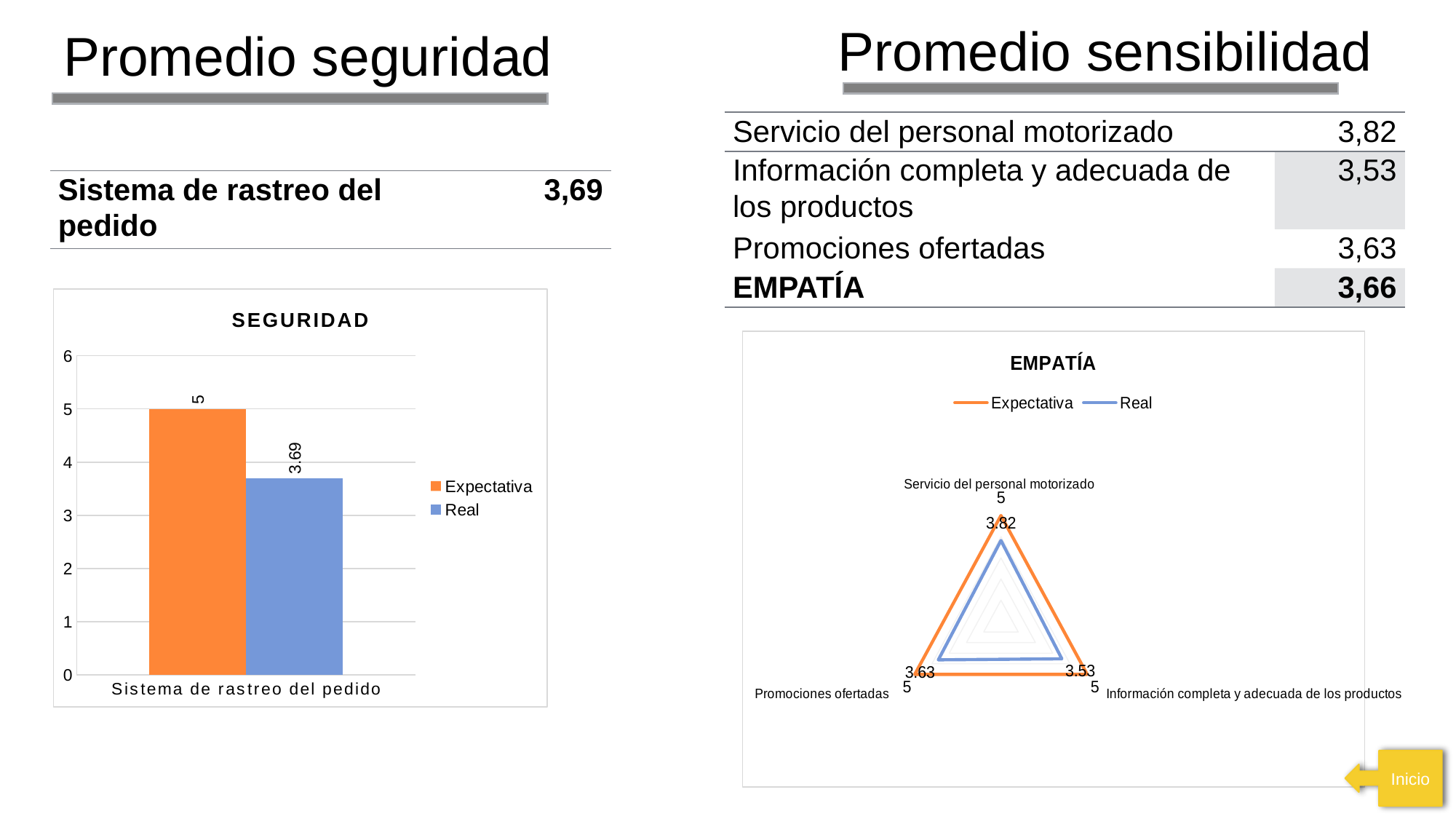
What kind of chart is the SEGURIDAD chart? Bar chart In the EMPATÍA chart, which category has the lowest Real value? Información completa y adecuada de los productos In the SEGURIDAD chart, which series has the larger value, Expectativa or Real? Expectativa In the SEGURIDAD chart, what is the value of the Real series for Sistema de rastreo del pedido? 3.69 In the SEGURIDAD chart, what is the value of the Expectativa series for Sistema de rastreo del pedido? 5 In the EMPATÍA chart, what is the Real value for Servicio del personal motorizado? 3.82 In the SEGURIDAD chart, is the Real value greater or less than 4? less What kind of chart is the EMPATÍA chart? Radar chart In the EMPATÍA chart, what is the Real value for Promociones ofertadas? 3.63 How many series does the legend of the SEGURIDAD chart list? 2 In the SEGURIDAD chart, what is the difference between the Expectativa and Real values? 1.31 How many categories does the EMPATÍA chart have? 3